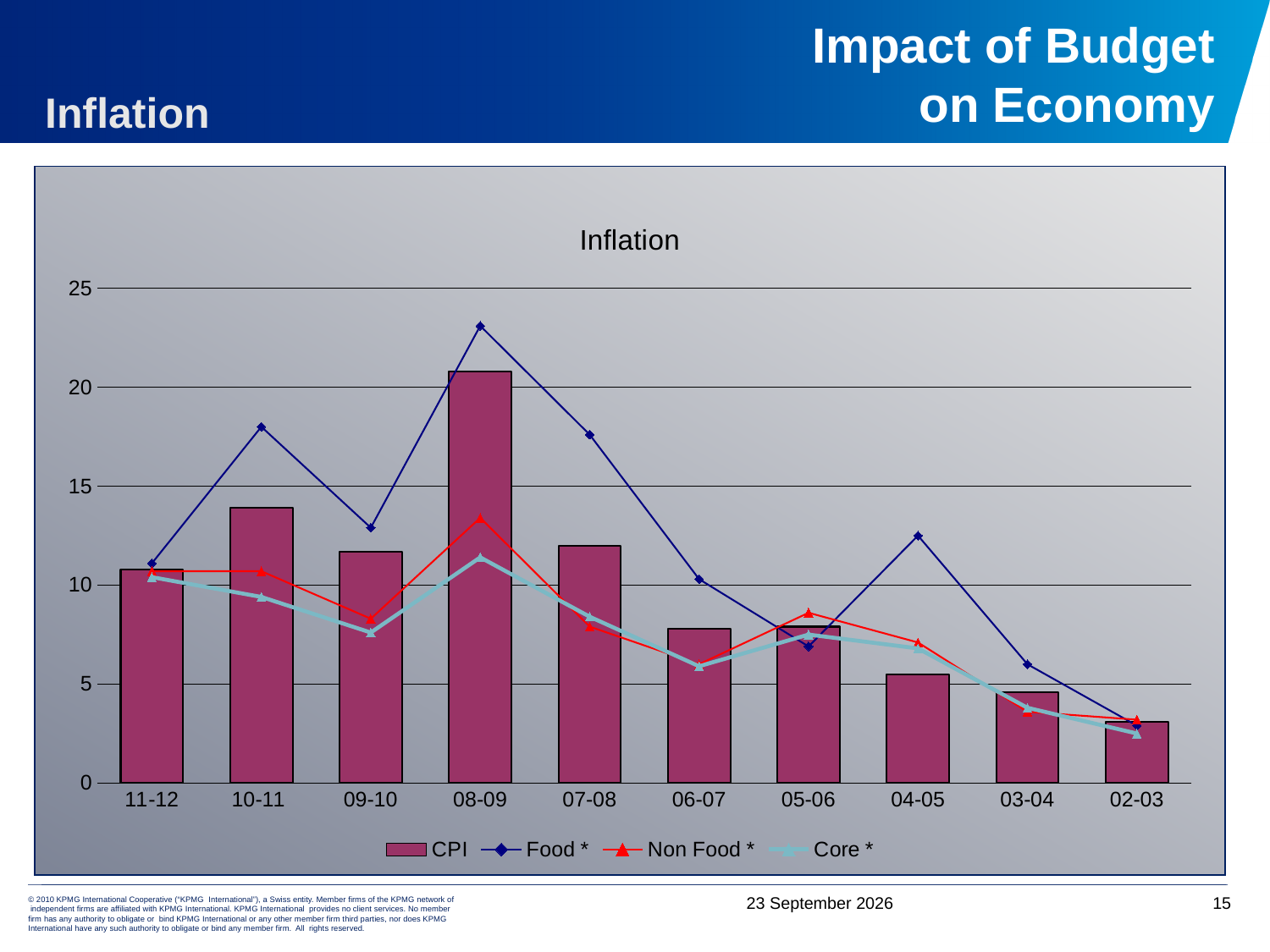
Is the CPI value for 08-09 greater or less than 20? greater Is the Core * value for 02-03 greater or less than 5? less Is the Food * value for 04-05 greater or less than 10? greater In which year does the Food * line reach its highest point? 08-09 How many series does the legend list? 4 What is the title of the chart? Inflation Which series is plotted as bars? CPI Which is larger in 10-11, the Food * value or the CPI value? Food * In which year is the CPI bar the lowest? 02-03 How many year categories are shown on the x axis? 10 What kind of chart is shown on the slide? A combined bar and line chart In which year is the CPI bar the highest? 08-09